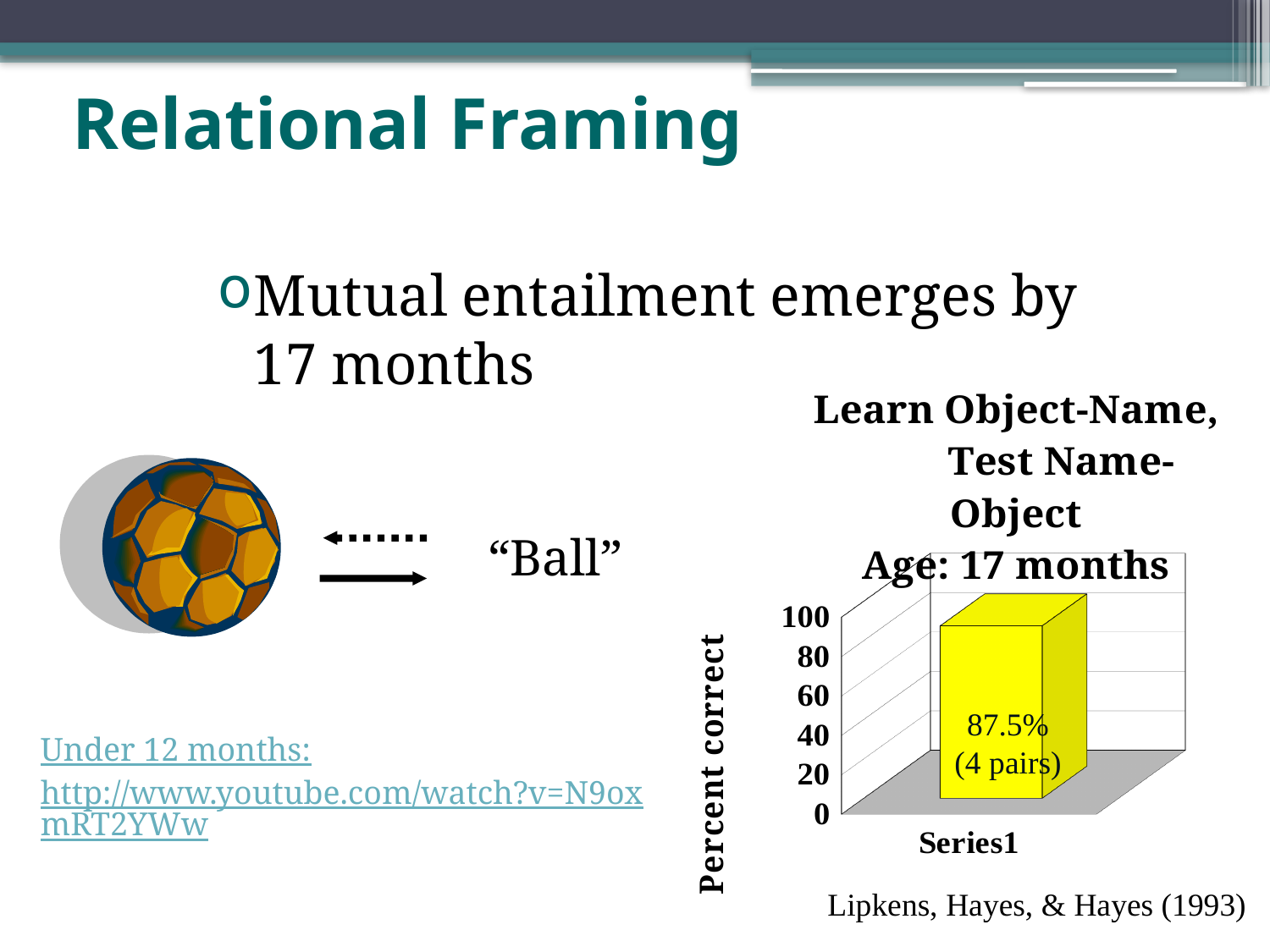
What value is printed on the bar in the chart? 87.5% What kind of chart is shown on the slide? bar chart How many pairs does the data label on the bar say were tested? 4 pairs What is the label on the y axis of the chart? Percent correct Is the value of the bar greater or less than 80? greater Is the value of the bar greater or less than 100? less How many bars does the chart show? 1 What is the category label shown under the bar? Series1 What is the highest tick value shown on the y axis of the chart? 100 What age is stated in the chart title? 17 months